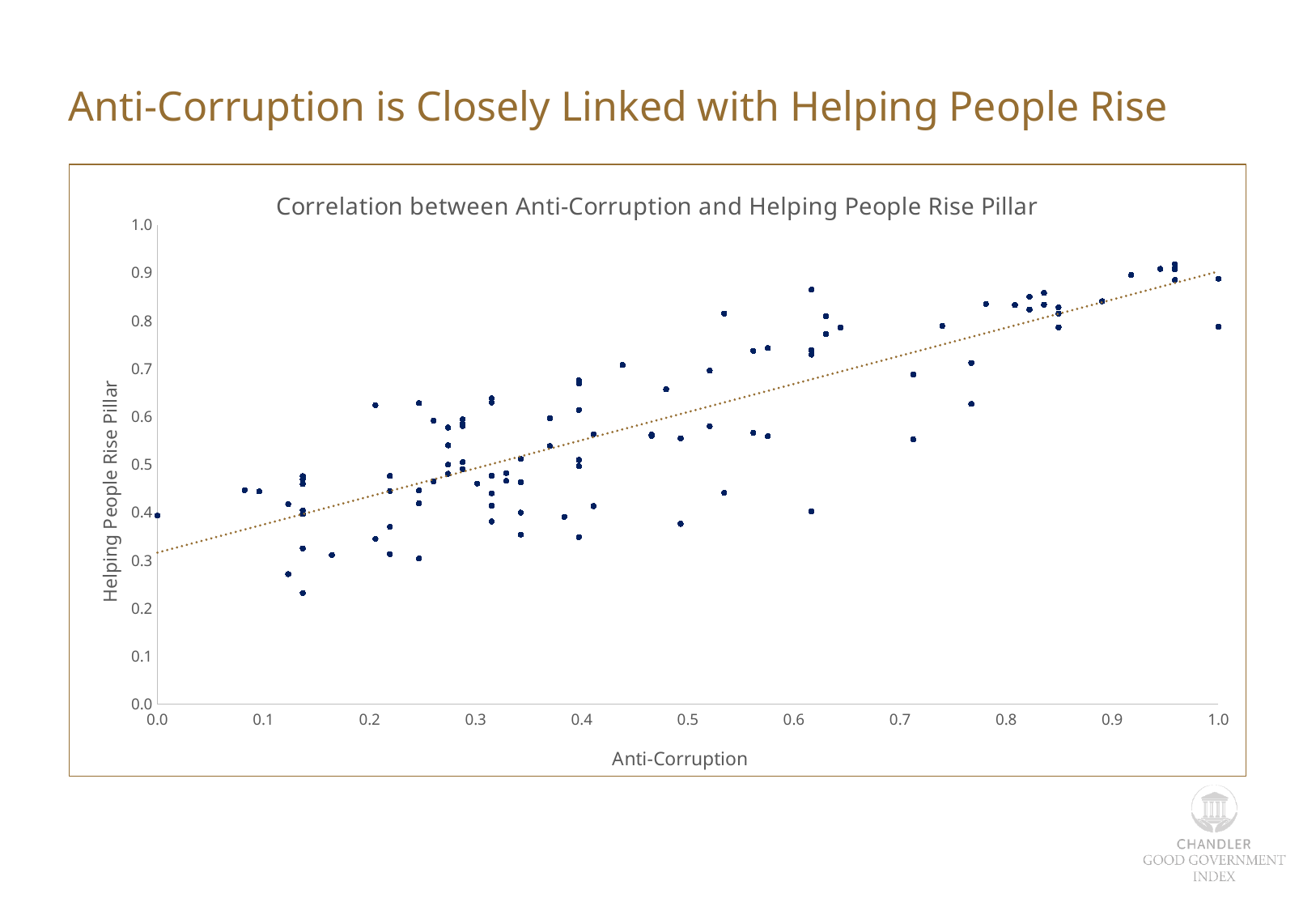
Is the value of the dotted trend line at Anti-Corruption 0.5 greater or less than 0.5? greater What is the label of the x axis of the chart? Anti-Corruption What kind of chart is shown on the slide? scatter plot Is the value of the dotted trend line at Anti-Corruption 1.0 greater or less than 0.8? greater Is the highest Helping People Rise Pillar value among the plotted points greater or less than 0.8? greater Do the Helping People Rise Pillar values generally rise or fall as Anti-Corruption increases along the x axis? rise What is the title of the chart? Correlation between Anti-Corruption and Helping People Rise Pillar